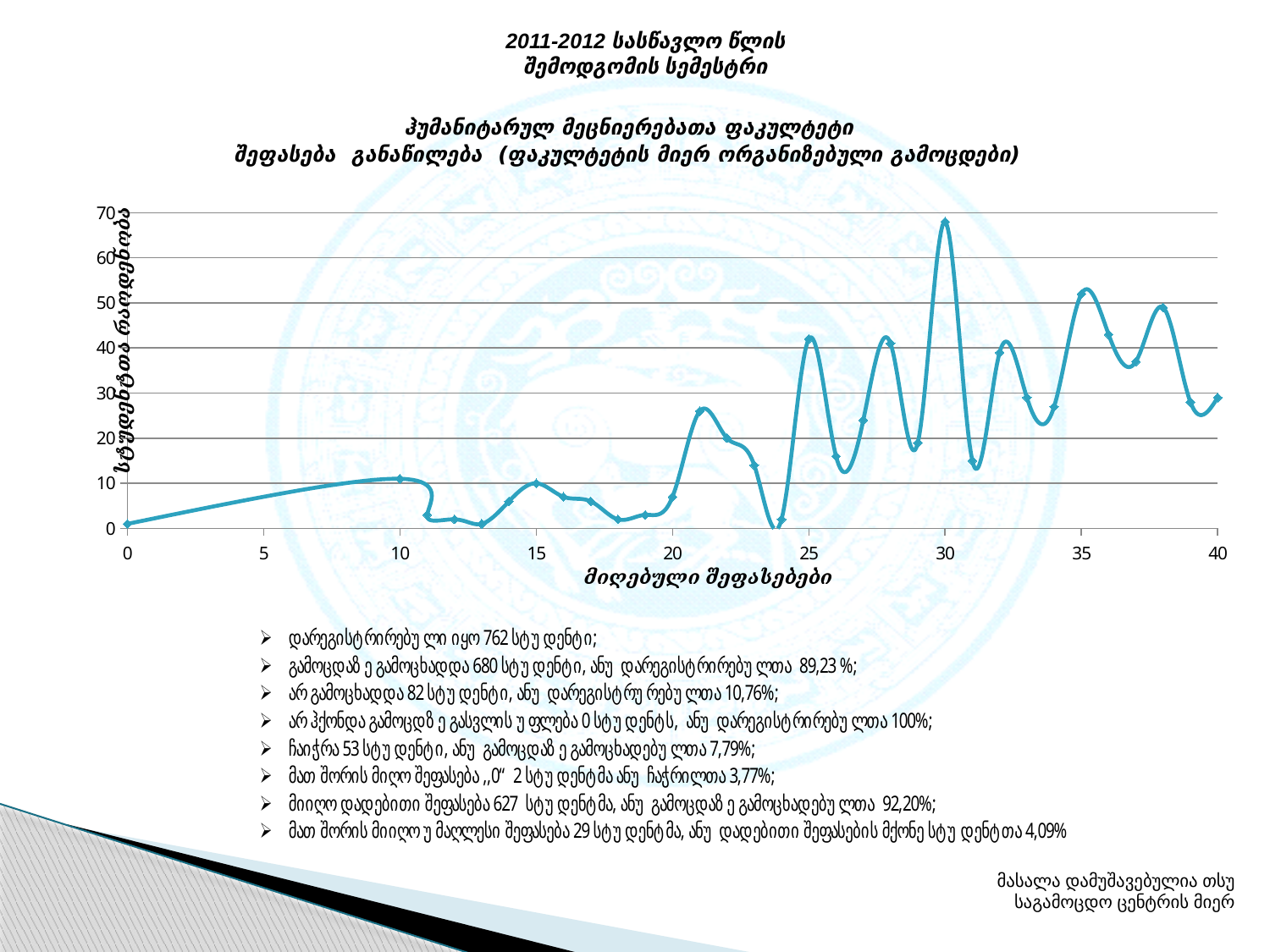
Is the value at x = 21 greater or less than 20? greater Is the value at x = 30 greater or less than 60? greater What is the title of the x axis? მიღებული შეფასებები Which has the larger value, x = 28 or x = 29? 28 Does the line rise or fall between x = 0 and x = 10? rise Which has the larger value, x = 30 or x = 35? 30 Is the value at x = 10 greater or less than 20? less What kind of chart is shown on the slide? line chart At which x-axis value does the line reach its highest point? 30